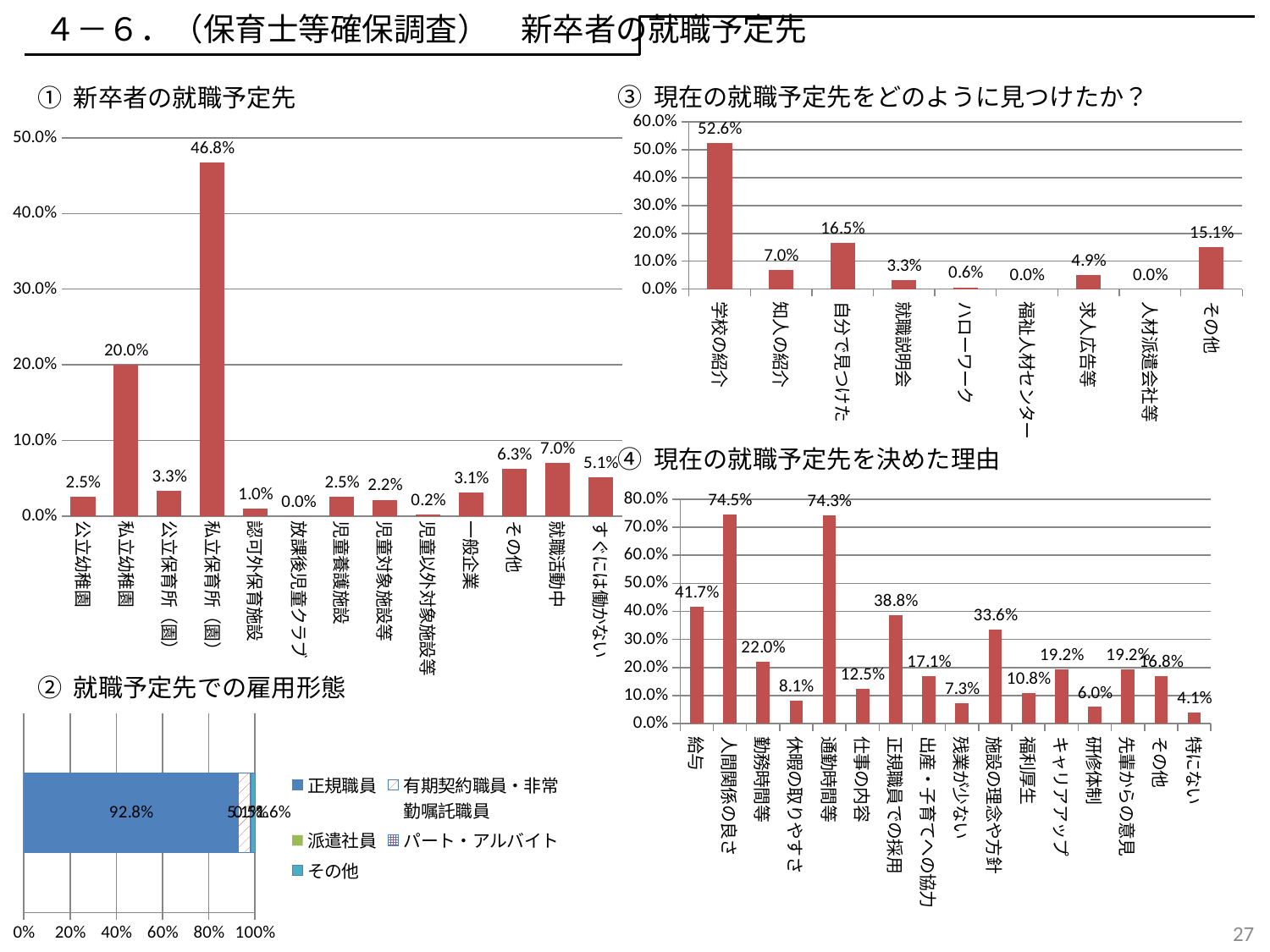
In the chart titled ② 就職予定先での雇用形態, what is the value for 正規職員? 92.8% In the chart titled ③ 現在の就職予定先をどのように見つけたか？, how many categories are shown on the x axis? 9 In the chart titled ① 新卒者の就職予定先, which category has the highest value? 私立保育所（園） In the chart titled ③ 現在の就職予定先をどのように見つけたか？, which is larger, 自分で見つけた or その他? 自分で見つけた In the chart titled ① 新卒者の就職予定先, how many categories are shown on the x axis? 13 In the chart titled ① 新卒者の就職予定先, what is the value for 私立保育所（園）? 46.8% In the chart titled ④ 現在の就職予定先を決めた理由, which category has the lowest value? 特にない In the chart titled ② 就職予定先での雇用形態, how many series does the legend list? 5 In the chart titled ① 新卒者の就職予定先, what is the difference between 私立幼稚園 and 公立幼稚園? 17.5% In the chart titled ④ 現在の就職予定先を決めた理由, what is the difference between 給与 and 正規職員での採用? 2.9% In the chart titled ③ 現在の就職予定先をどのように見つけたか？, what is the value for 学校の紹介? 52.6% In the chart titled ④ 現在の就職予定先を決めた理由, what is the value for 施設の理念や方針? 33.6%